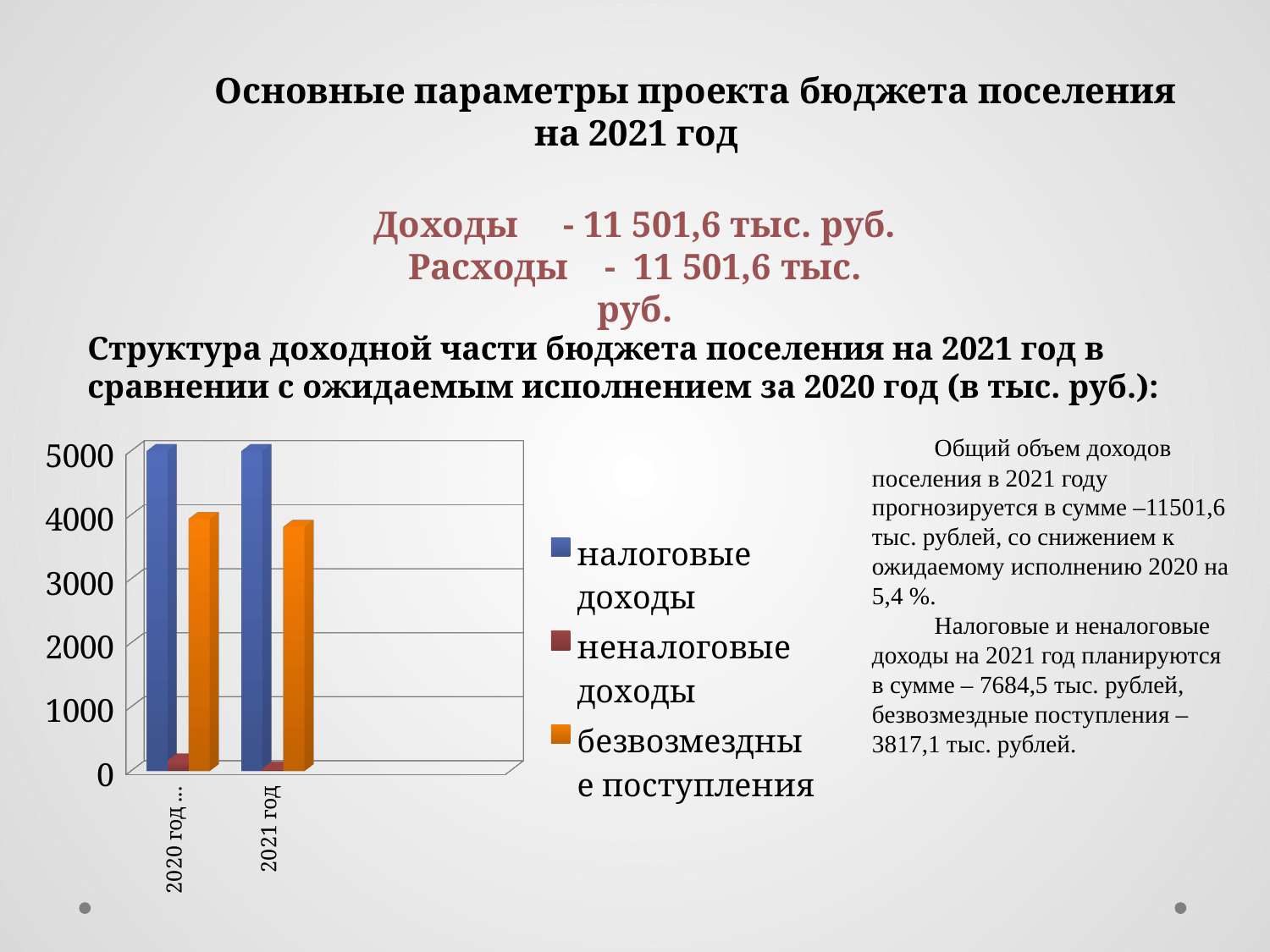
How many series does the chart legend list? 3 For 2021 год, which is larger: налоговые доходы or безвозмездные поступления? налоговые доходы Which series has the highest bar for 2021 год? налоговые доходы Is the value for неналоговые доходы in 2021 год greater or less than 1000? less Is the value for налоговые доходы in 2020 год greater or less than 4000? greater How many year categories are shown on the x axis of the chart? 2 Is the value for безвозмездные поступления in 2021 год greater or less than 3000? greater Does the value for безвозмездные поступления rise or fall from 2020 год to 2021 год? fall What kind of chart is shown on the slide? bar chart Which series has the lowest bar for 2021 год? неналоговые доходы Which series is shown in orange in the chart legend? безвозмездные поступления Which series is shown in blue in the chart legend? налоговые доходы